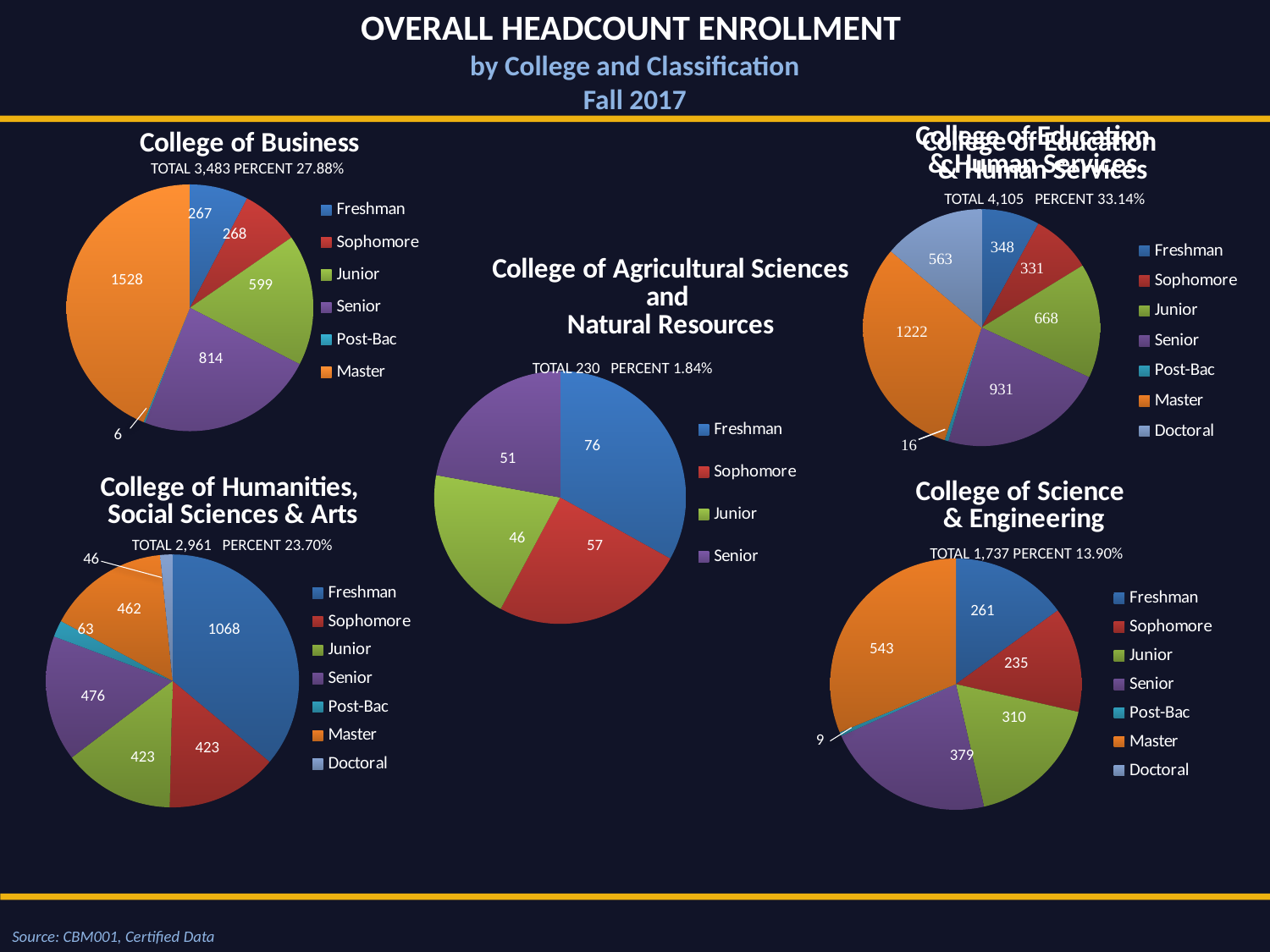
How many entries does the legend of the College of Humanities, Social Sciences & Arts chart list? 7 On the College of Science & Engineering chart, which classification has the largest slice? Master On the College of Agricultural Sciences and Natural Resources chart, which classification has the smallest slice? Junior How many slices does the College of Agricultural Sciences and Natural Resources chart have? 4 On the College of Education & Human Services chart, which is larger, Junior or Sophomore? Junior On the College of Humanities, Social Sciences & Arts chart, what is the value for Freshman? 1068 What kind of chart is used for the College of Science & Engineering? Pie chart On the College of Agricultural Sciences and Natural Resources chart, what is the value for Sophomore? 57 On the College of Education & Human Services chart, what is the value for Senior? 931 What total is printed above the College of Education & Human Services chart? 4,105 On the College of Business chart, what is the value for Master? 1528 On the College of Business chart, what is the difference between the Master value and the Senior value? 714